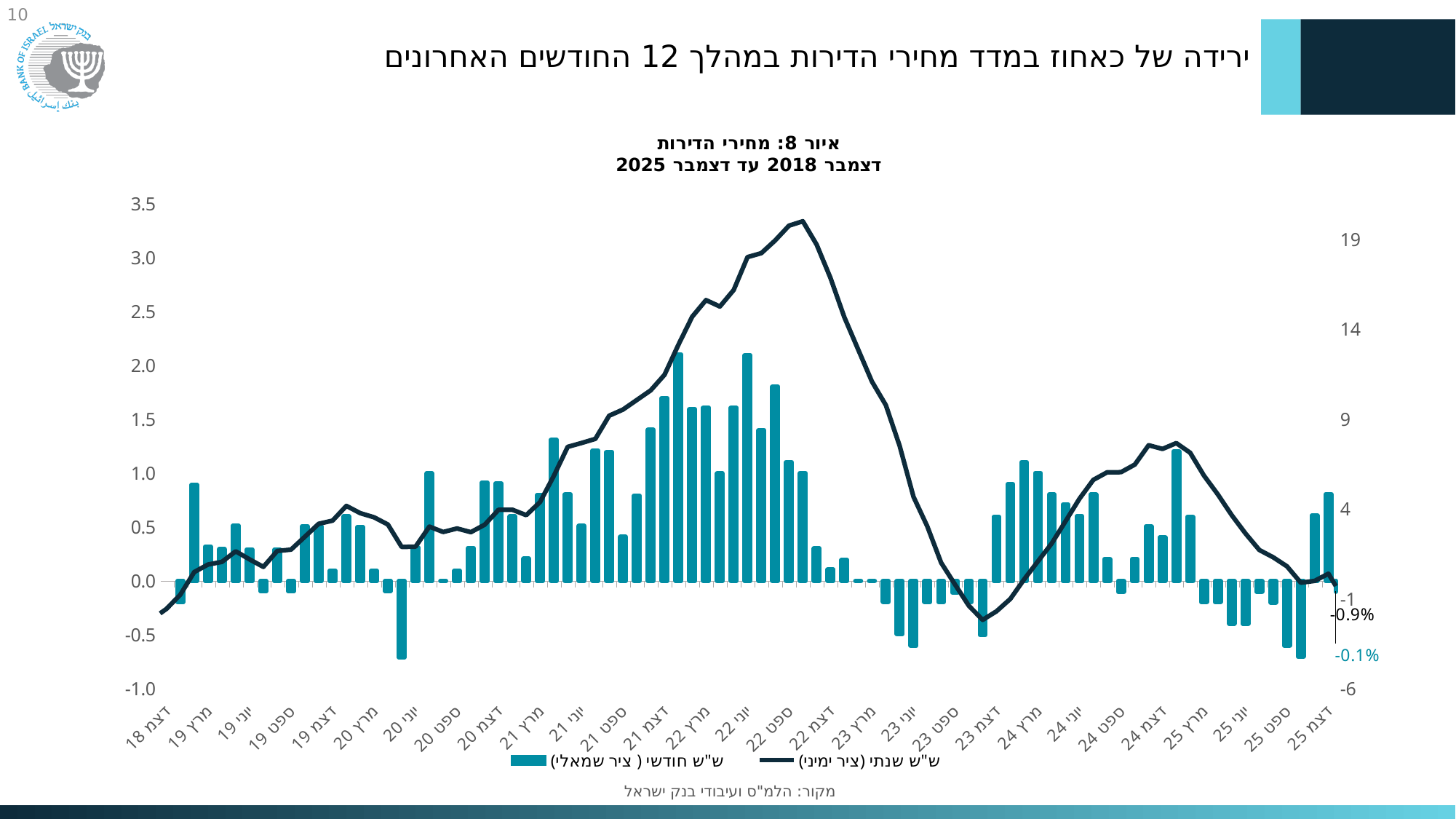
At דצמ 25, which is larger: the monthly change (-0.1%) or the annual change (-0.9%)? The monthly change (-0.1%) What kind of chart is shown on the slide? A combined bar and line chart What is the labelled value of the monthly change (bar series) at דצמ 25? -0.1% Is the peak of the annual change line (around mid-2022) greater or less than 14 on the right axis? greater What is the title of the chart? איור 8: מחירי הדירות דצמבר 2018 עד דצמבר 2025 What is the difference between the monthly change (-0.1%) and the annual change (-0.9%) labelled at דצמ 25? 0.8% Does the annual change line rise or fall between its peak in mid-2022 and ספט 23? It falls Does the annual change line rise or fall overall from דצמ 18 to mid-2022? It rises What is the labelled value of the annual change (line series) at דצמ 25? -0.9% How many series does the legend list? 2 What are the two series named in the legend? ש"ש חודשי (ציר שמאלי) and ש"ש שנתי (ציר ימיני) Is the lowest monthly bar (around יוני 20) greater or less than -0.5 on the left axis? less